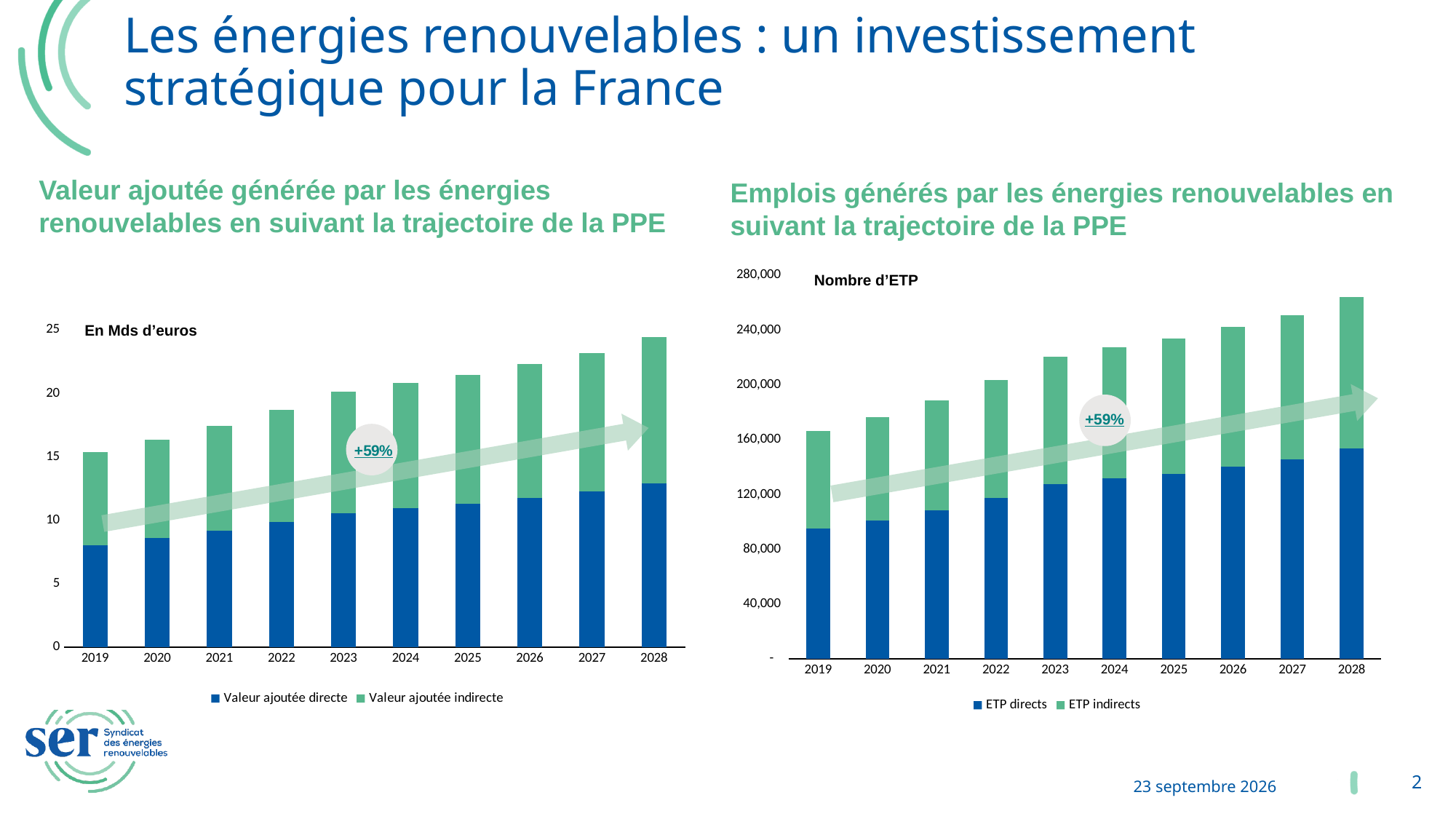
On the left chart (Valeur ajoutée), how many series does the legend list? 2 On the right chart (Emplois générés), what are the two series listed in the legend? ETP directs and ETP indirects On the left chart (Valeur ajoutée), which year has the highest total bar? 2028 On the left chart (Valeur ajoutée), is the total value for 2019 greater or less than 20? less What kind of chart is the left chart, 'Valeur ajoutée générée par les énergies renouvelables'? Stacked bar chart On the right chart (Emplois générés), do the total bars rise or fall from 2019 to 2028? Rise On the left chart (Valeur ajoutée), which year has the lowest total bar? 2019 On the left chart (Valeur ajoutée), is the total value for 2028 greater or less than 20? greater On the left chart (Valeur ajoutée), what unit is stated for the values? En Mds d'euros On the left chart (Valeur ajoutée), how many years are shown on the x axis? 10 On the right chart (Emplois générés), is the total value for 2019 greater or less than 200,000? less